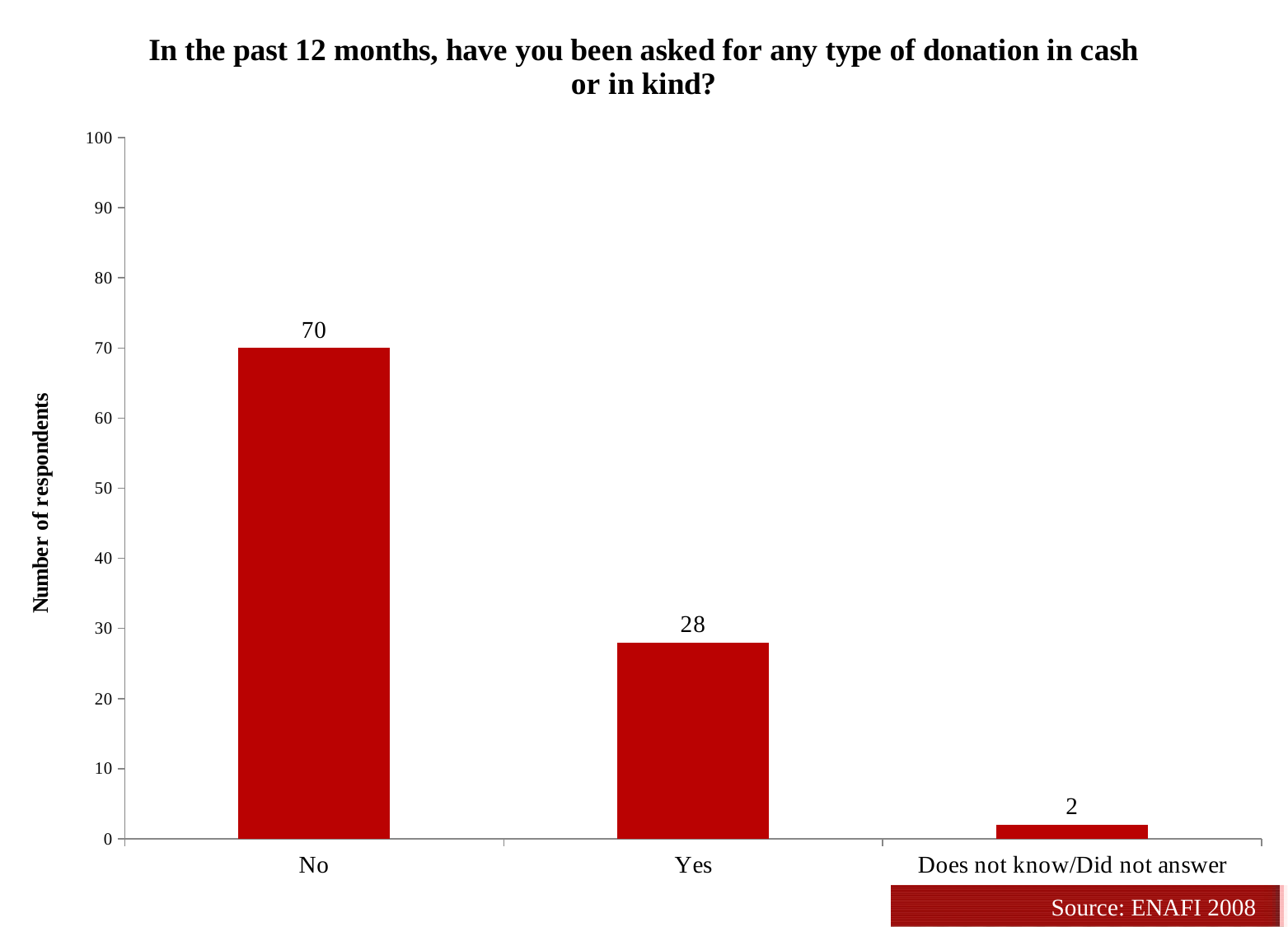
Is the value for "Yes" greater or less than 30? less What is the number of respondents who answered "Yes"? 28 What is the label of the vertical axis? Number of respondents Which response category has the lowest number of respondents? Does not know/Did not answer Which response category has the highest number of respondents? No What kind of chart is shown on the slide? Bar chart What is the number of respondents who answered "No"? 70 Which has more respondents, "Yes" or "Does not know/Did not answer"? Yes What is the number of respondents for "Does not know/Did not answer"? 2 What is the difference between the number of respondents who answered "No" and those who answered "Yes"? 42 What source is cited for the chart data? ENAFI 2008 How many response categories are shown on the x axis? 3